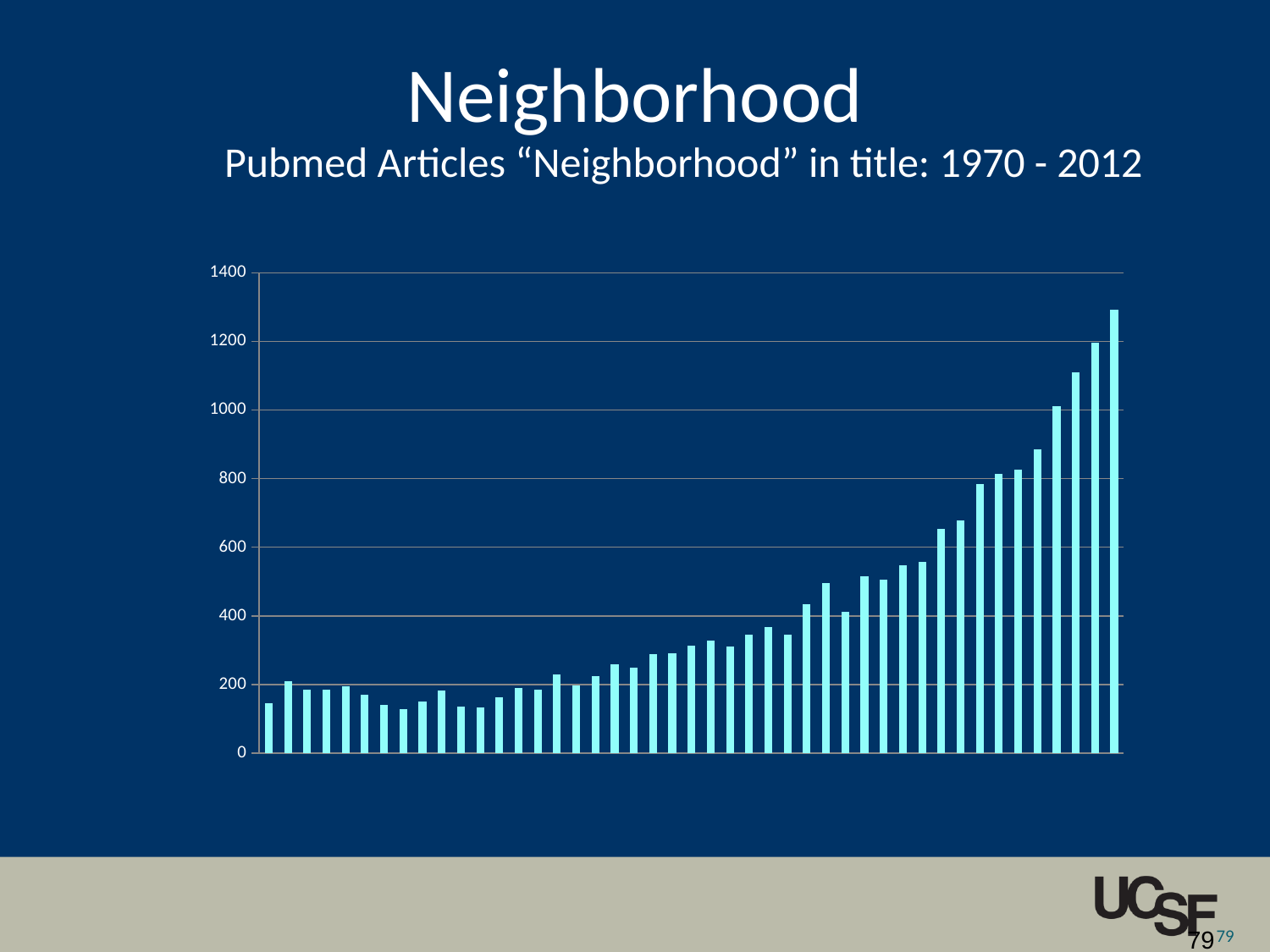
Is the value of the tallest bar greater or less than 1000? greater What kind of chart is shown on the slide? Bar chart Is the value of the leftmost (first) bar greater or less than 200? less What is the highest value shown on the vertical axis? 1400 Is the value of the rightmost (last) bar greater or less than 1200? greater Do the values generally rise or fall from left to right across the chart? Rise What is the subtitle of the chart on the slide? Pubmed Articles "Neighborhood" in title: 1970 - 2012 Which bar is the highest: the leftmost bar or the rightmost bar? The rightmost bar Where on the chart is the tallest bar located? At the far right (the last bar)